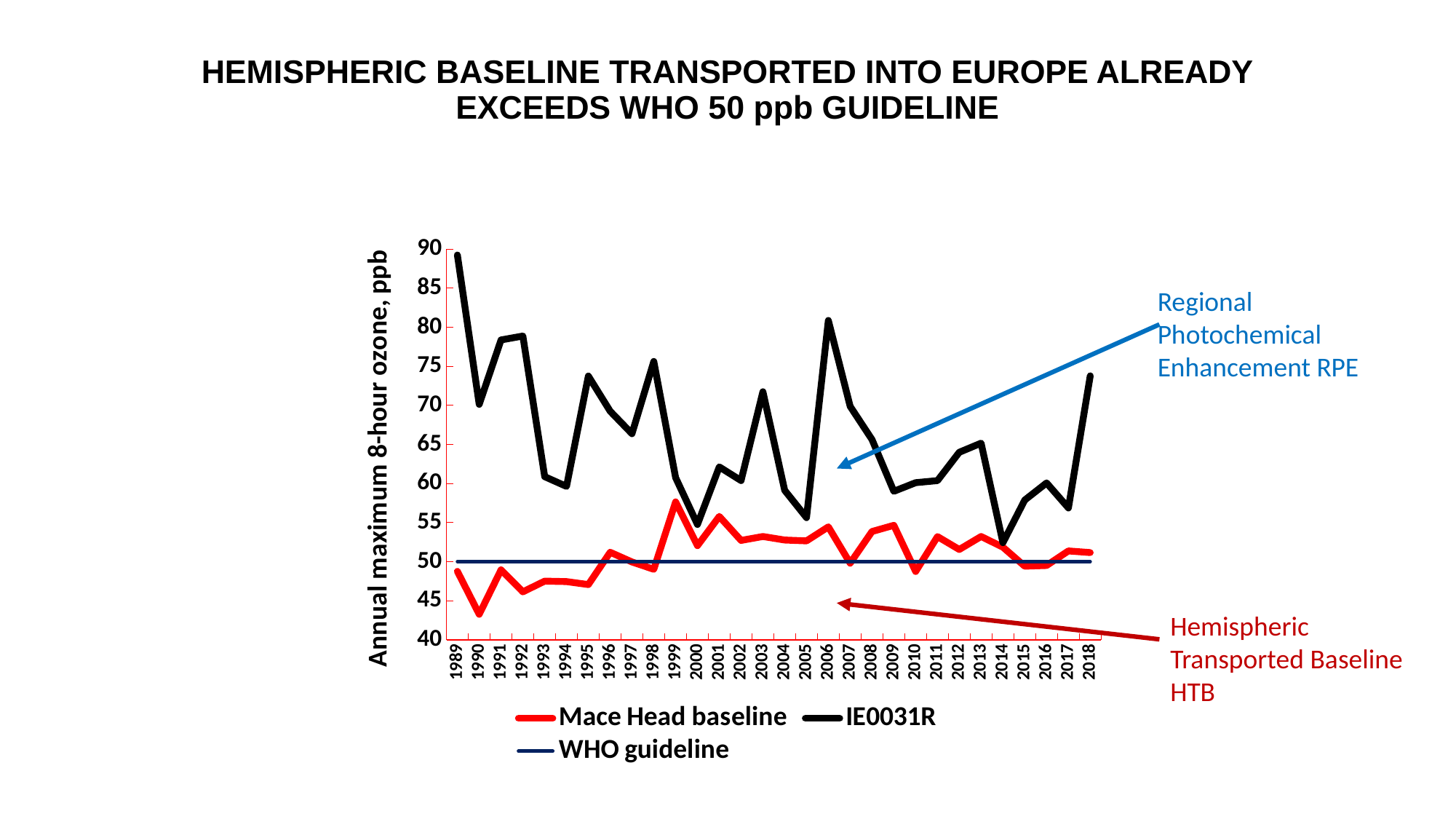
Is the IE0031R value for 1989 greater or less than 85? greater Is the Mace Head baseline value for 1990 greater or less than 45? less How many series does the legend list? 3 What is the title of the y axis? Annual maximum 8-hour ozone, ppb How many years are plotted along the x axis? 30 Which series has the larger value in 2006, IE0031R or Mace Head baseline? IE0031R In which year is the IE0031R series highest? 1989 What value does the WHO guideline line sit at? 50 In which year is the Mace Head baseline series lowest? 1990 What kind of chart is shown on the slide? line chart Is the IE0031R value for 2014 greater or less than 55? less In which year is the Mace Head baseline series highest? 1999